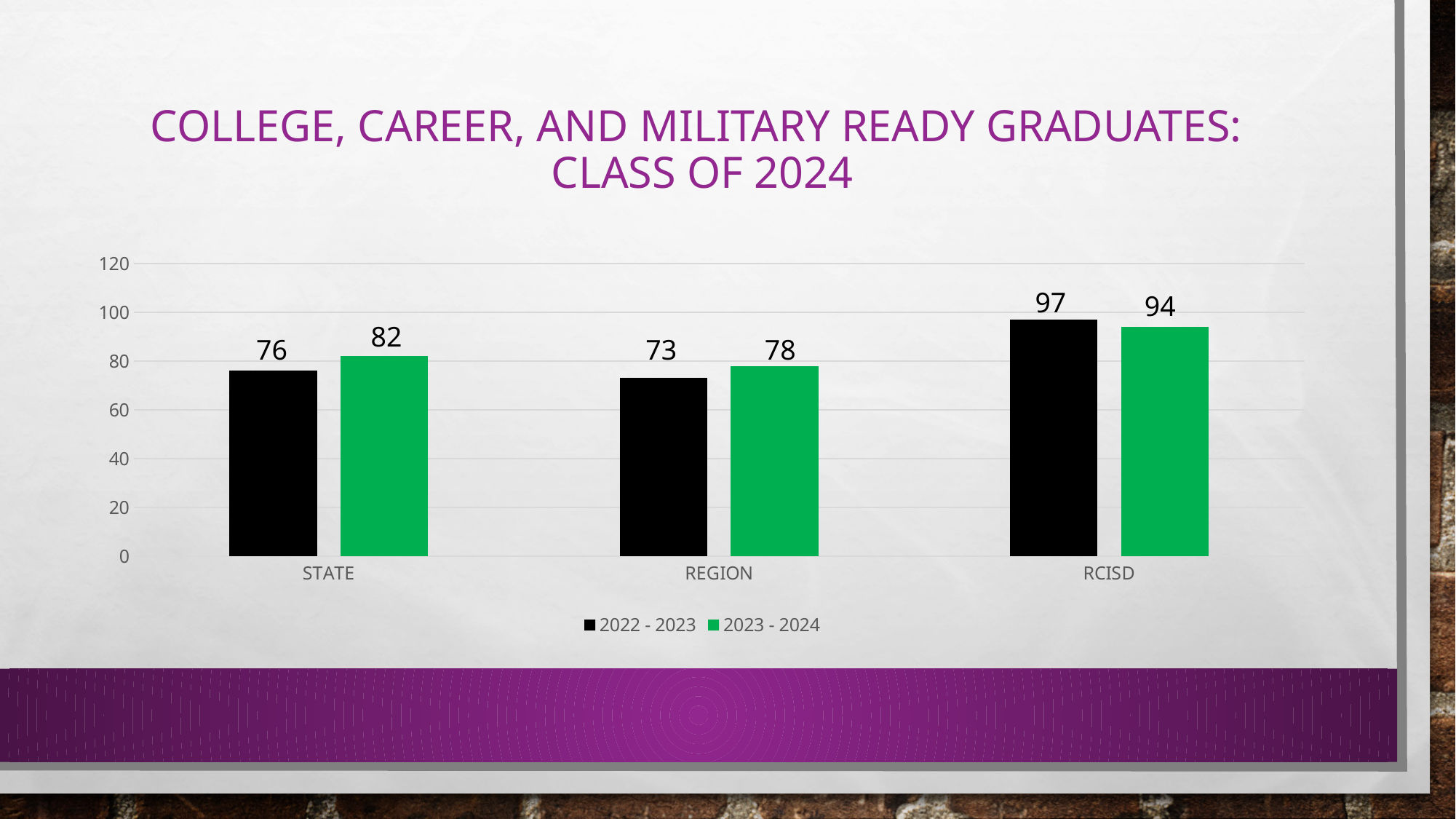
For REGION, which is larger: the 2022 - 2023 value or the 2023 - 2024 value? 2023 - 2024 What is the 2022 - 2023 value for STATE? 76 What colour are the bars for the 2023 - 2024 series? green What is the 2023 - 2024 value for RCISD? 94 Which category has the highest 2022 - 2023 value? RCISD Which category has the lowest 2023 - 2024 value? REGION What is the 2023 - 2024 value for REGION? 78 What is the difference between the 2022 - 2023 and 2023 - 2024 values for RCISD? 3 How many categories are shown on the x axis? 3 How many series does the legend list? 2 What kind of chart is shown on the slide? bar chart What is the difference between the 2023 - 2024 and 2022 - 2023 values for STATE? 6